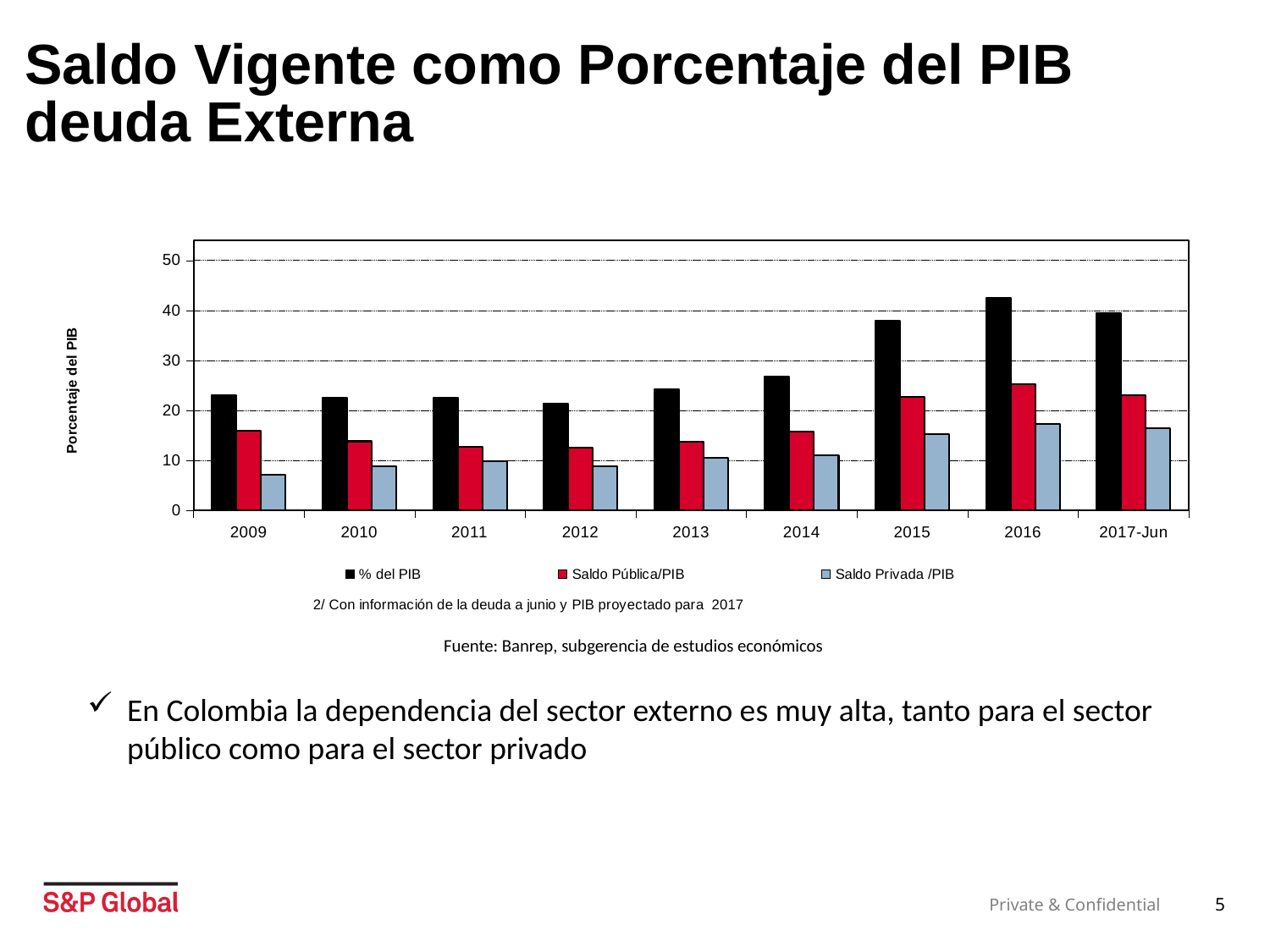
How many series does the legend list? 3 Is the value for % del PIB in 2014 greater or less than 30? less In which year is the value for Saldo Privada /PIB lowest? 2009 Does the value for % del PIB rise or fall from 2012 to 2016? rise In which year is the value for Saldo Pública/PIB highest? 2016 Is the value for Saldo Privada /PIB in 2009 greater or less than 10? less How many year categories are shown on the x axis? 9 Which is larger, the value for % del PIB in 2015 or in 2014? 2015 What kind of chart is shown on the slide? bar chart In which year is the value for % del PIB highest? 2016 What is the title of the vertical axis? Porcentaje del PIB Is the value for % del PIB in 2016 greater or less than 40? greater